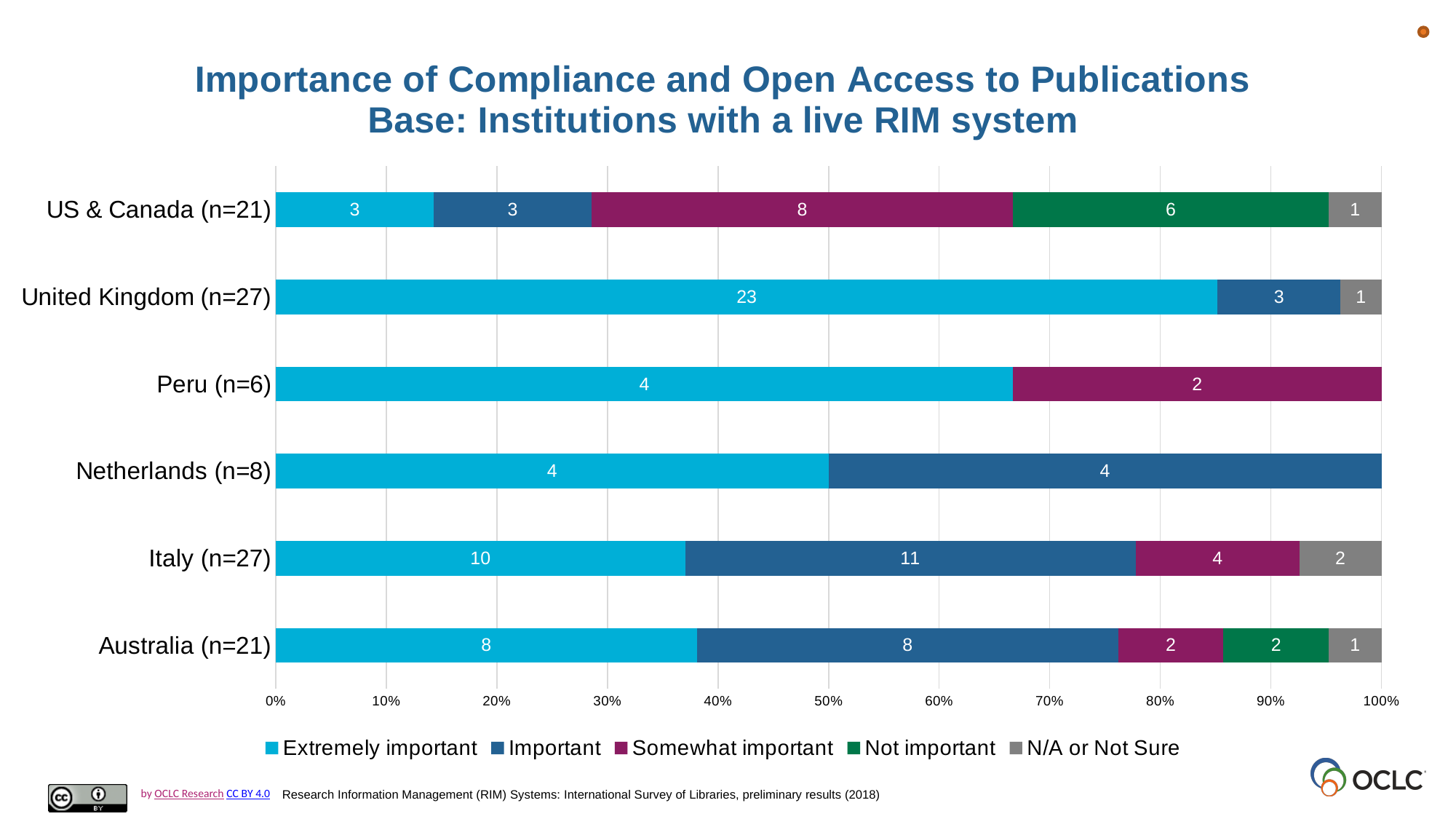
Which has the larger value for Important: Australia (n=21) or Italy (n=27)? Italy (n=27) Which category has the highest value for Extremely important? United Kingdom (n=27) How many categories are shown on the y axis? 6 What colour represents Not important in the legend? Green What is the value for Important for Italy (n=27)? 11 What is the total of all segments in the Australia (n=21) bar? 21 What kind of chart is shown on the slide? Stacked bar chart What is the difference between the Important and Extremely important values for Italy (n=27)? 1 How many series does the legend list? 5 What is the value for Extremely important for United Kingdom (n=27)? 23 What is the value for Somewhat important for US & Canada (n=21)? 8 Which category has the lowest value for Extremely important? US & Canada (n=21)